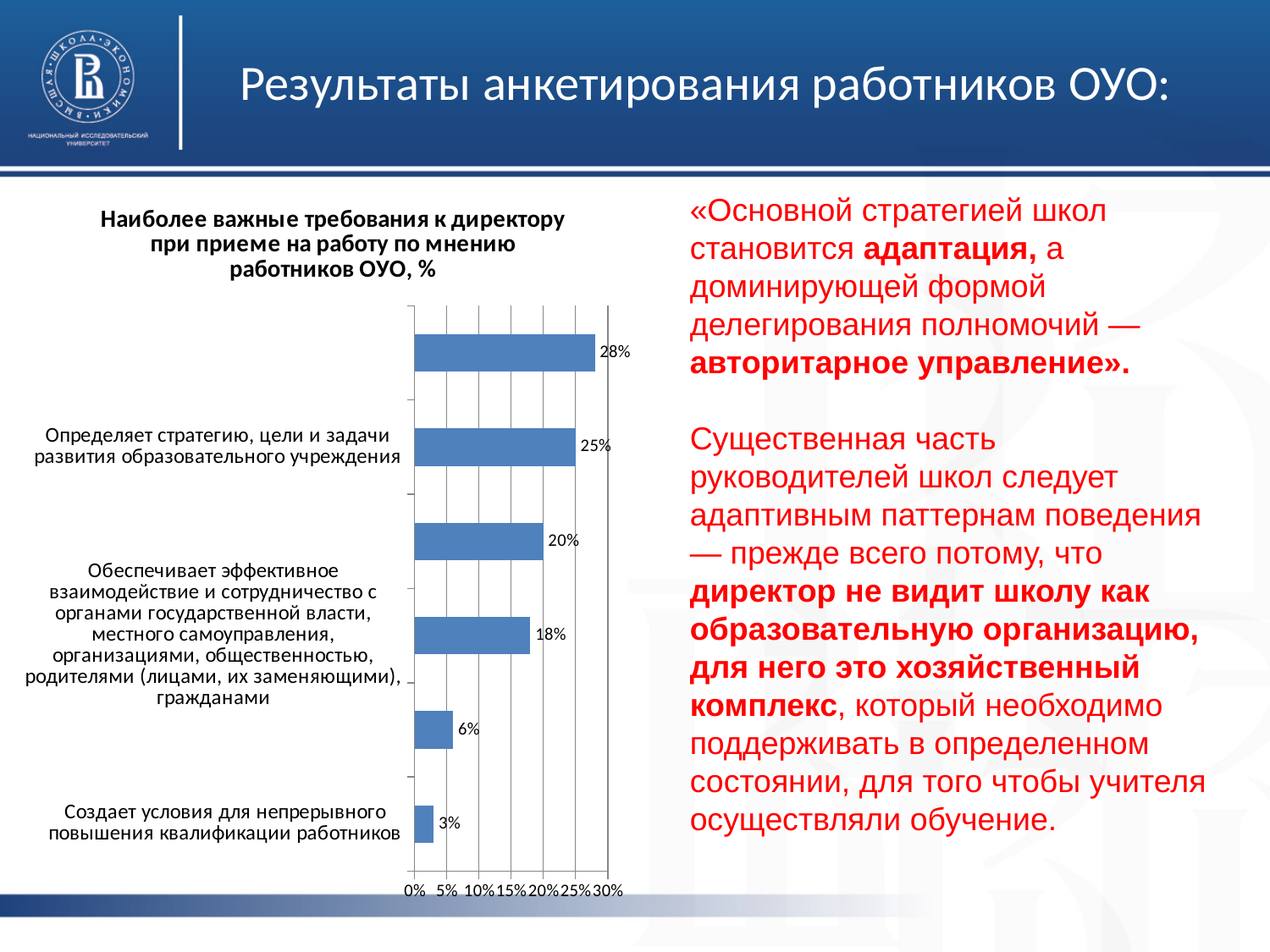
Which is larger: the value of the top bar or the value of the second bar from the top? the top bar (28%) How many bars does the chart contain? 6 What is the lowest value shown in the chart? 3% What is the difference between the highest value (28%) and the lowest value (3%) in the chart? 25 percentage points What is the value for the category 'Создает условия для непрерывного повышения квалификации работников'? 3% What is the title of the chart? Наиболее важные требования к директору при приеме на работу по мнению работников ОУО, % What kind of chart is shown on the slide? bar chart Do the bar values increase or decrease going from the top of the chart to the bottom? decrease What is the value for the category 'Определяет стратегию, цели и задачи развития образовательного учреждения'? 25% Is the value of the top bar greater or less than 25%? greater What is the maximum value shown on the horizontal axis of the chart? 30% What is the highest value shown in the chart? 28%